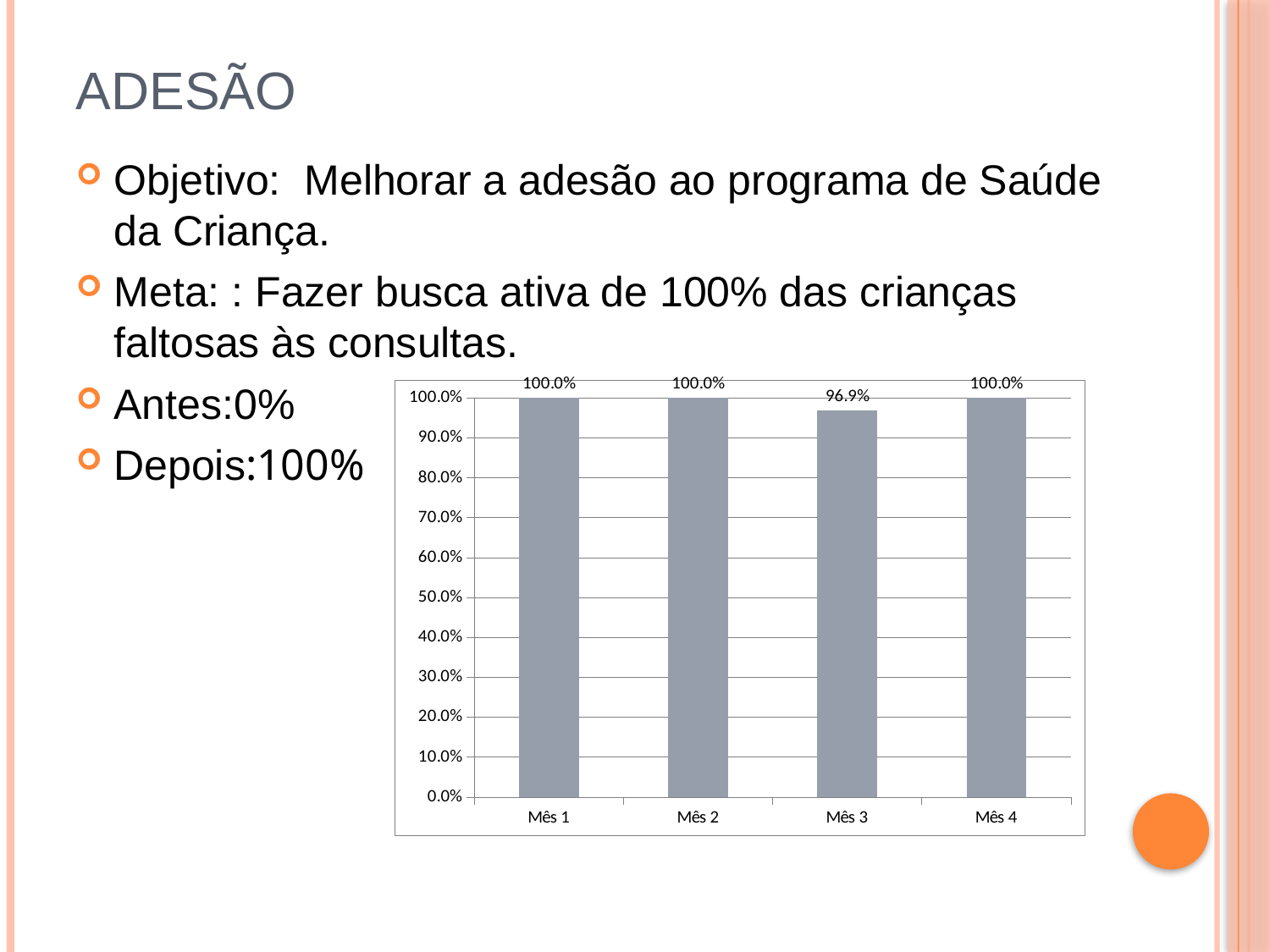
How many months are shown on the x axis of the chart? 4 Which month has the lowest value? Mês 3 Is the value for Mês 3 greater or less than 90.0%? greater What is the difference between the values for Mês 2 and Mês 3? 3.1% How many months have a value of 100.0%? 3 What is the value for Mês 4? 100.0% What is the value for Mês 3? 96.9% What kind of chart is shown on the slide? bar chart Which is larger, the value for Mês 3 or the value for Mês 4? Mês 4 What is the label of the first category on the x axis? Mês 1 What is the value for Mês 1? 100.0% What is the highest tick label on the y axis of the chart? 100.0%